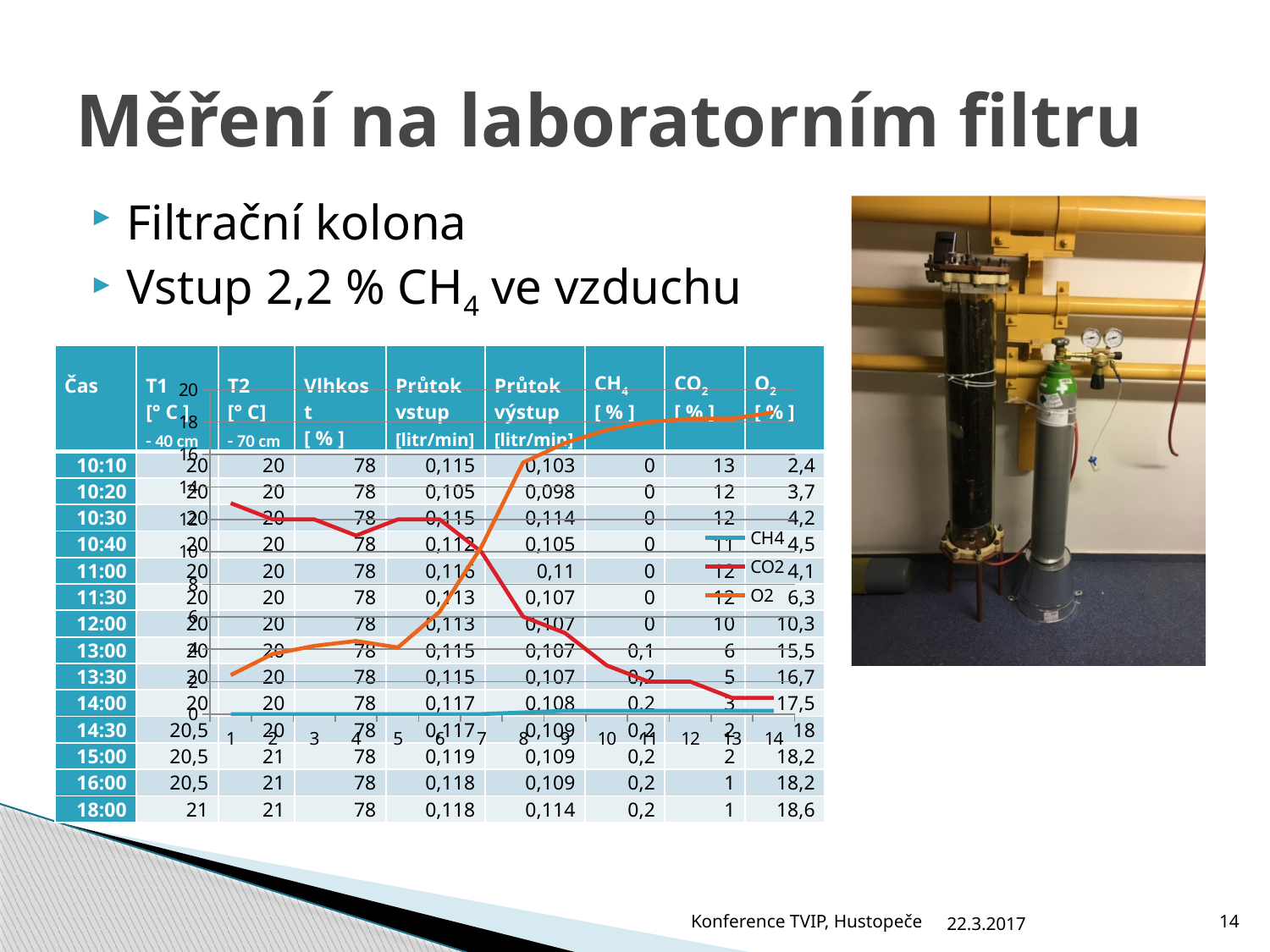
What kind of chart is overlaid on the table on this slide? line chart Does the O2 line rise or fall from left to right along the x axis? rise How many points are marked along the chart's x axis? 14 Which series are listed in the chart's legend? CH4, CO2, O2 At x = 14, which series has the larger value, O2 or CO2? O2 Is the value of the CO2 line at x = 1 greater or less than 10? greater Does the CO2 line rise or fall from left to right along the x axis? fall At x = 1, which series has the larger value, CO2 or O2? CO2 Is the value of the O2 line at x = 14 greater or less than 16? greater Is the value of the CH4 line at x = 1 greater or less than 2? less Which series stays lowest across the whole chart? CH4 How many series does the chart's legend list? 3